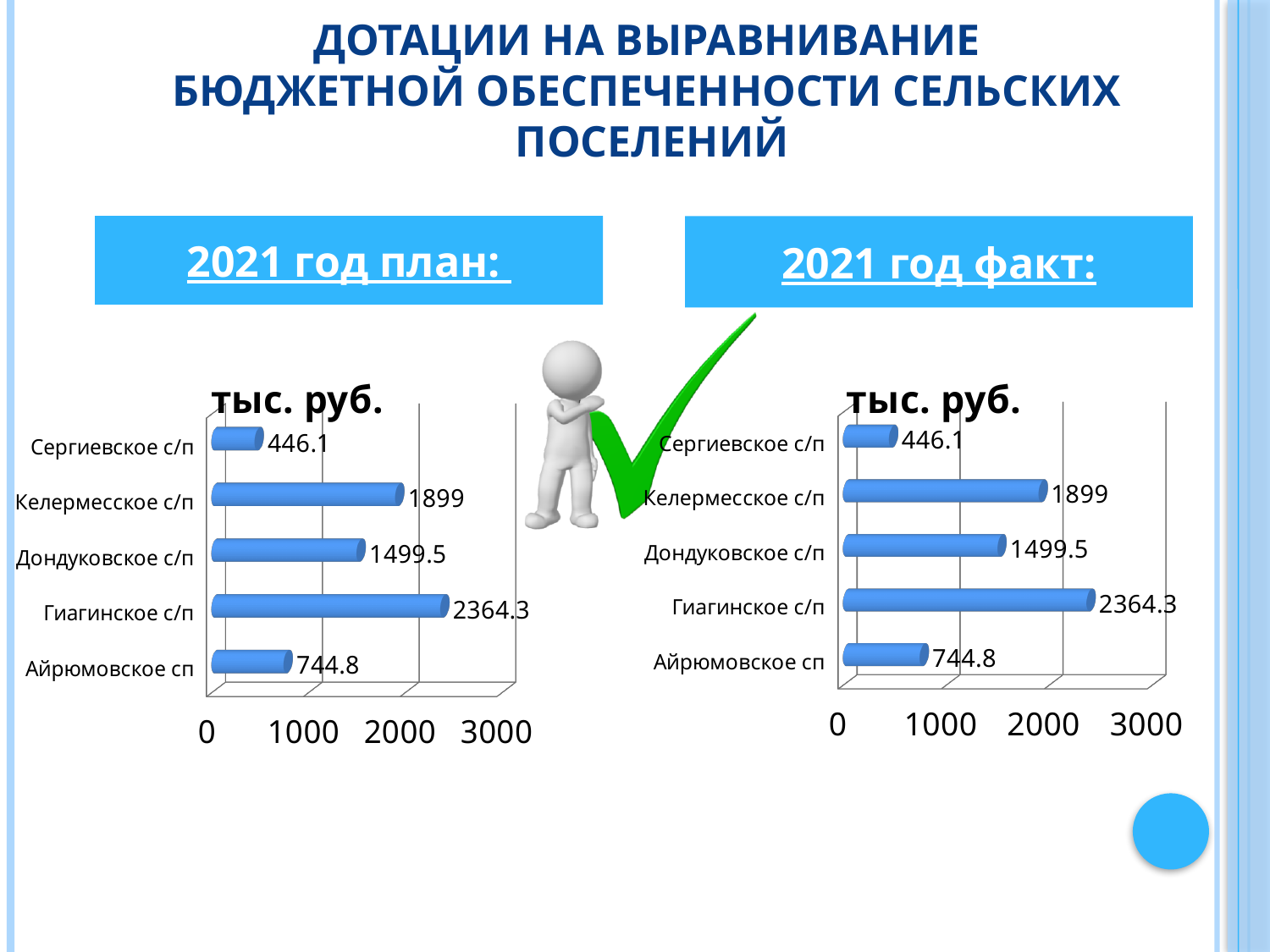
In the right chart (2021 год факт), is the value for Келермесское с/п greater or less than 1000? greater In the left chart (2021 год план), what is the value for Сергиевское с/п? 446.1 In the right chart (2021 год факт), which category has the highest value? Гиагинское с/п What is the title of the left chart (2021 год план)? тыс. руб. In the right chart (2021 год факт), what is the value for Айрюмовское сп? 744.8 In the left chart (2021 год план), what is the value for Гиагинское с/п? 2364.3 In the right chart (2021 год факт), which is larger: Дондуковское с/п or Айрюмовское сп? Дондуковское с/п What type of chart is the right chart (2021 год факт)? bar chart In the left chart (2021 год план), which category has the lowest value? Сергиевское с/п In the left chart (2021 год план), what is the difference between Келермесское с/п and Дондуковское с/п? 399.5 In the right chart (2021 год факт), what is the difference between Гиагинское с/п and Сергиевское с/п? 1918.2 How many categories are shown in the left chart (2021 год план)? 5